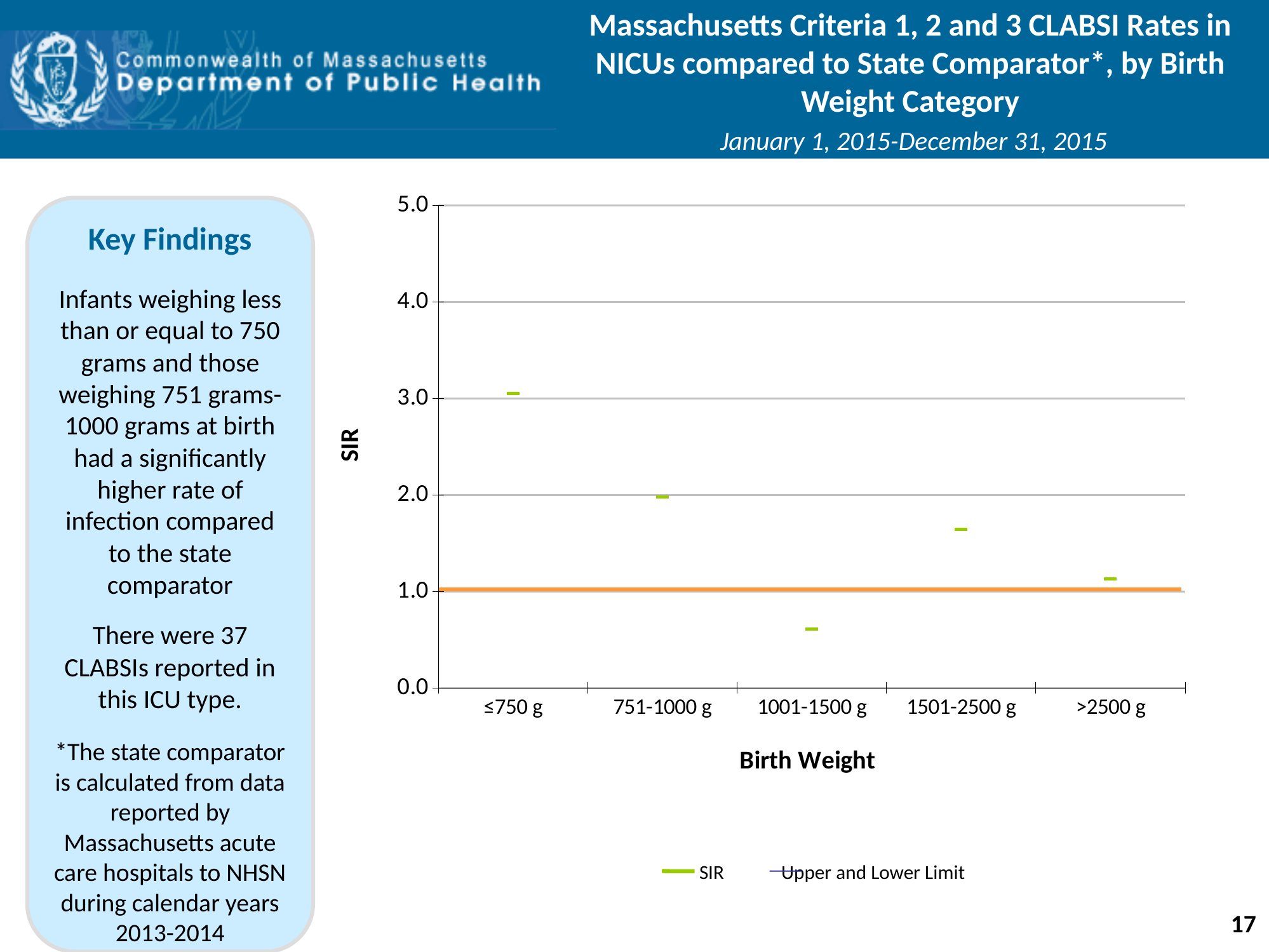
Is the SIR for 1001-1500 g greater or less than 1.0? less How many series does the legend list? 2 Which birth weight category has the highest SIR? ≤750 g Which has a higher SIR, ≤750 g or 751-1000 g? ≤750 g What is the title of the y axis? SIR How many birth weight categories are shown on the x axis? 5 Is the SIR for 1501-2500 g greater or less than 2.0? less Is the SIR for ≤750 g greater or less than 2.0? greater Which has a higher SIR, 1001-1500 g or 1501-2500 g? 1501-2500 g Which birth weight category has the lowest SIR? 1001-1500 g